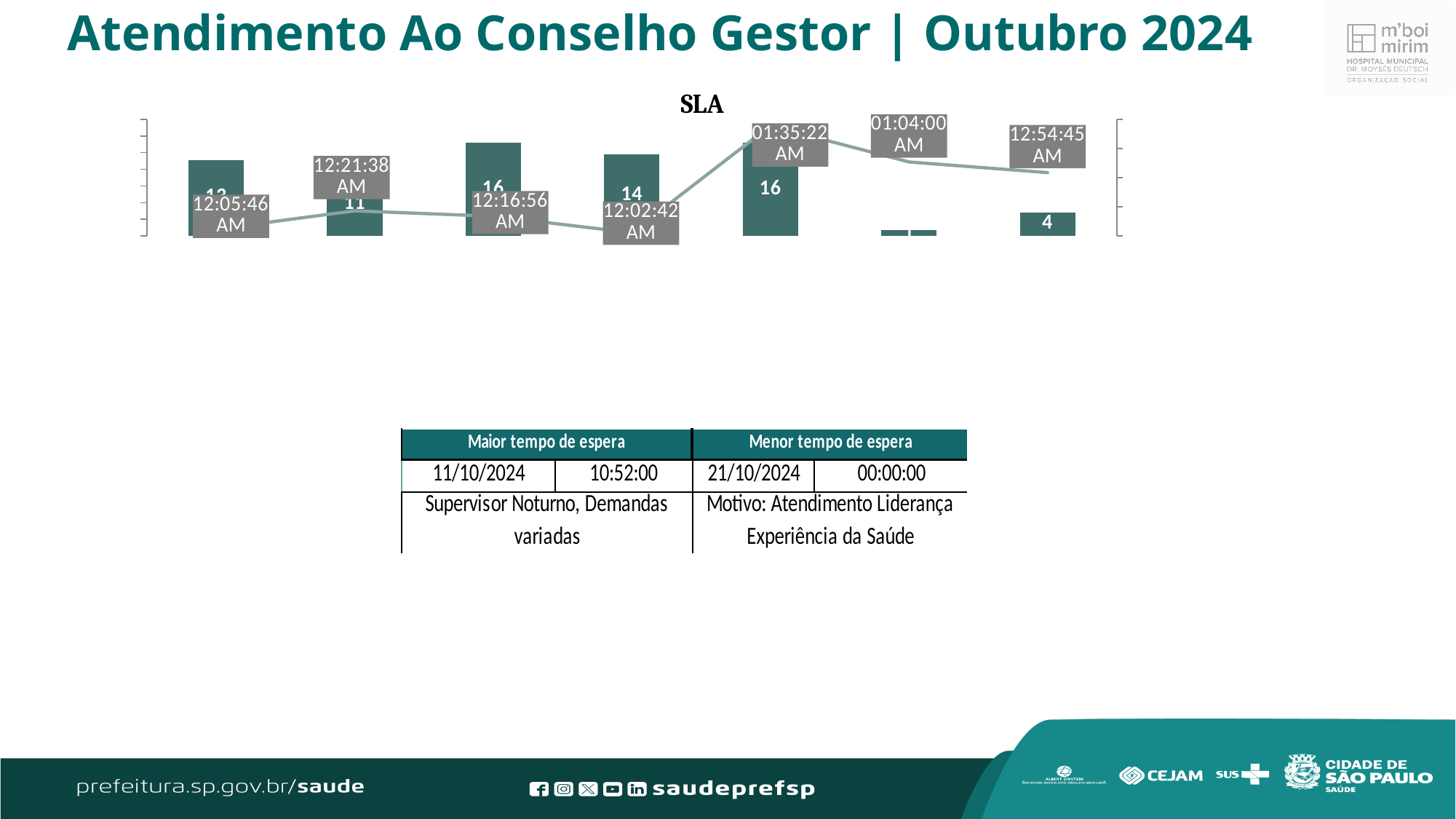
In the SLA chart, what is the line value labelled at the fifth point from the left? 01:35:22 AM What kind of chart is the SLA chart? Combined bar and line chart In the SLA chart, which is larger: the second bar or the fourth bar? The fourth bar (14) In the SLA chart, what is the highest value labelled on any bar? 16 In the SLA chart, which line label shows the highest time value? 01:35:22 AM In the SLA chart, what is the value labelled on the last bar on the right? 4 In the SLA chart, what is the value labelled on the second bar from the left? 11 How many bars are plotted in the SLA chart? 7 What is the title of the chart on the slide? SLA In the SLA chart, what is the value labelled on the fourth bar from the left? 14 In the SLA chart, what is the difference between the fourth bar (14) and the last bar (4)? 10 In the SLA chart, what is the line value labelled at the last point on the right? 12:54:45 AM